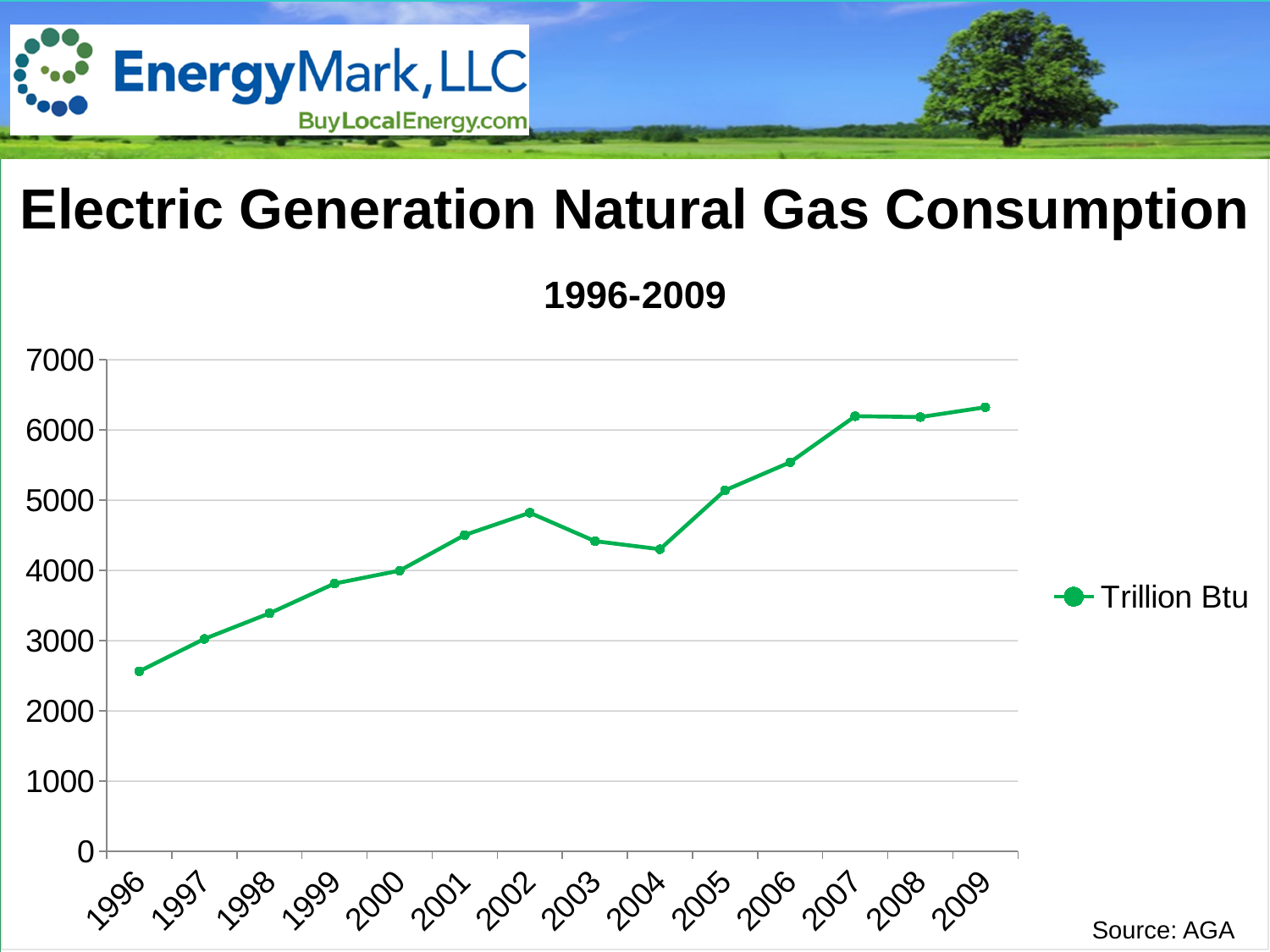
Is the value for 2004 greater or less than 5000? less Do the values generally rise or fall from 1996 to 2009? rise What source is cited for the chart data? AGA Is the value for 2007 greater or less than 6000? greater How many series does the legend list? 1 Which year has the higher value, 2002 or 2003? 2002 What is the name of the series shown in the legend? Trillion Btu How many years are plotted on the x axis of the chart? 14 Is the value for 1996 greater or less than 3000? less What kind of chart is shown on the slide? Line chart Which year has the lowest natural gas consumption on the chart? 1996